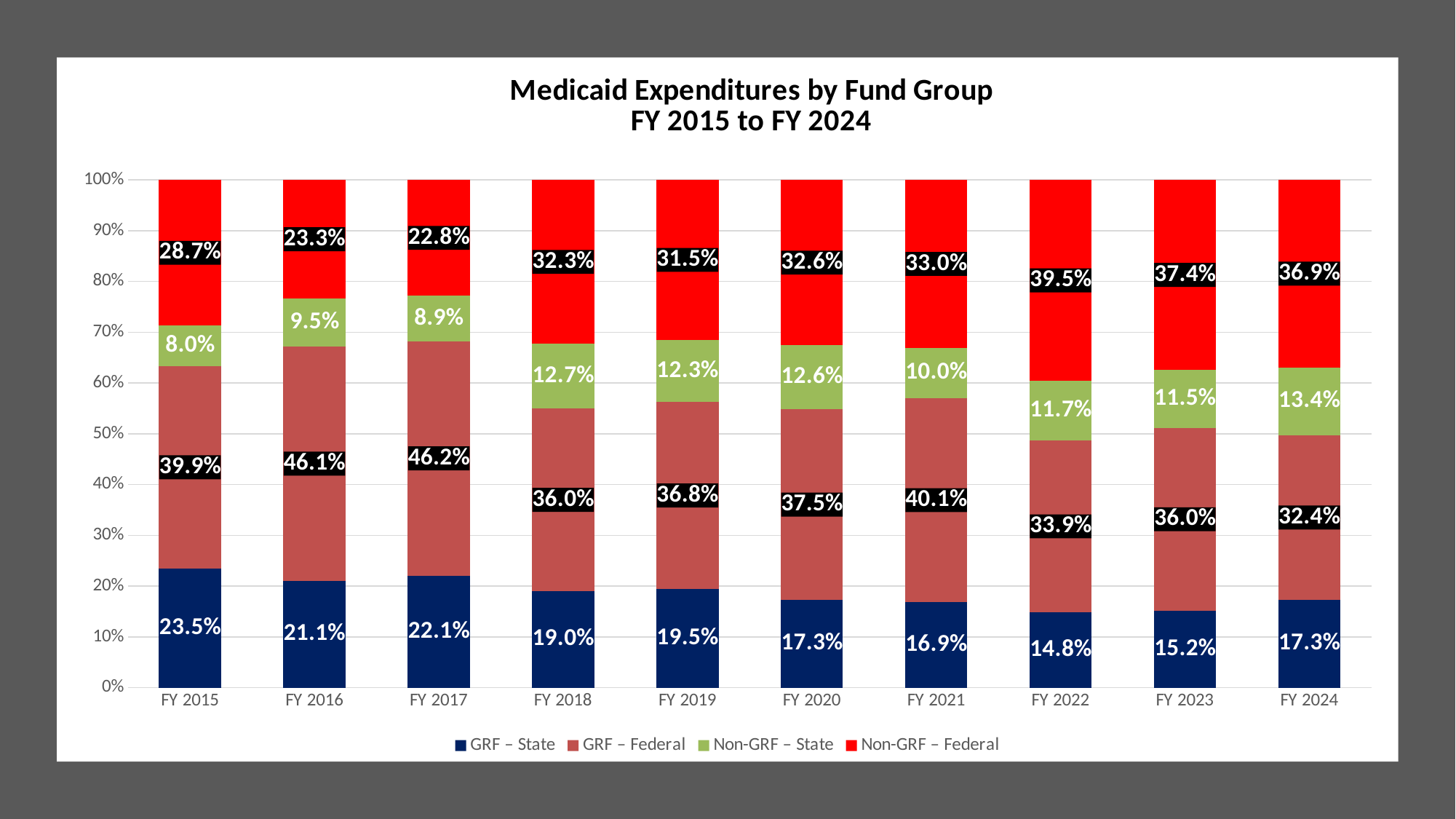
What is the GRF – State share in FY 2015? 23.5% In which fiscal year is the GRF – State share the lowest? FY 2022 What is the GRF – Federal share in FY 2017? 46.2% Does the GRF – State share generally rise or fall from FY 2015 to FY 2022? Fall Which is larger in FY 2023: the GRF – Federal share or the Non-GRF – Federal share? Non-GRF – Federal What is the difference between the GRF – Federal share in FY 2016 and in FY 2024? 13.7% In which fiscal year is the Non-GRF – Federal share the highest? FY 2022 What is the Non-GRF – State share in FY 2024? 13.4% What kind of chart is this? Stacked bar chart What is the Non-GRF – Federal share in FY 2022? 39.5% How many fiscal years are shown on the x axis? 10 How many series does the legend list? 4